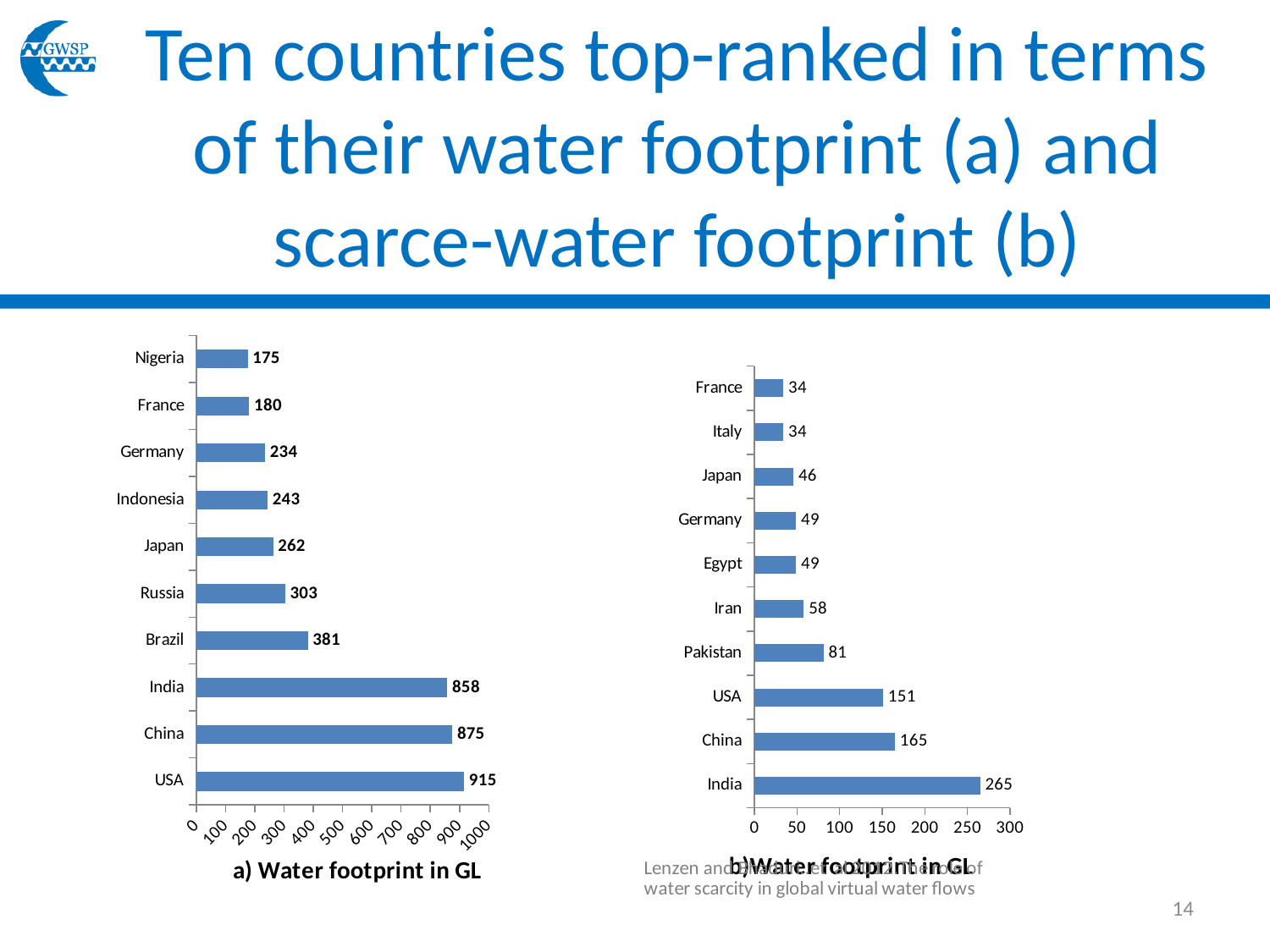
What type of chart is the left chart (a) Water footprint in GL? Bar chart In the right chart (b), which is larger, the value for USA or the value for Iran? USA In the right chart (b), what is the value for Pakistan? 81 In the left chart (a) Water footprint in GL, which is larger, the value for Russia or the value for Japan? Russia In the right chart (b), how many countries are shown? 10 In the left chart (a) Water footprint in GL, what is the value for Brazil? 381 In the left chart (a) Water footprint in GL, which country has the highest value? USA In the left chart (a) Water footprint in GL, which country has the lowest value? Nigeria In the left chart (a) Water footprint in GL, what is the difference between the values for China and India? 17 In the right chart (b), what is the difference between the values for India and China? 100 In the left chart (a) Water footprint in GL, how many countries are shown? 10 In the right chart (b), which country has the highest value? India